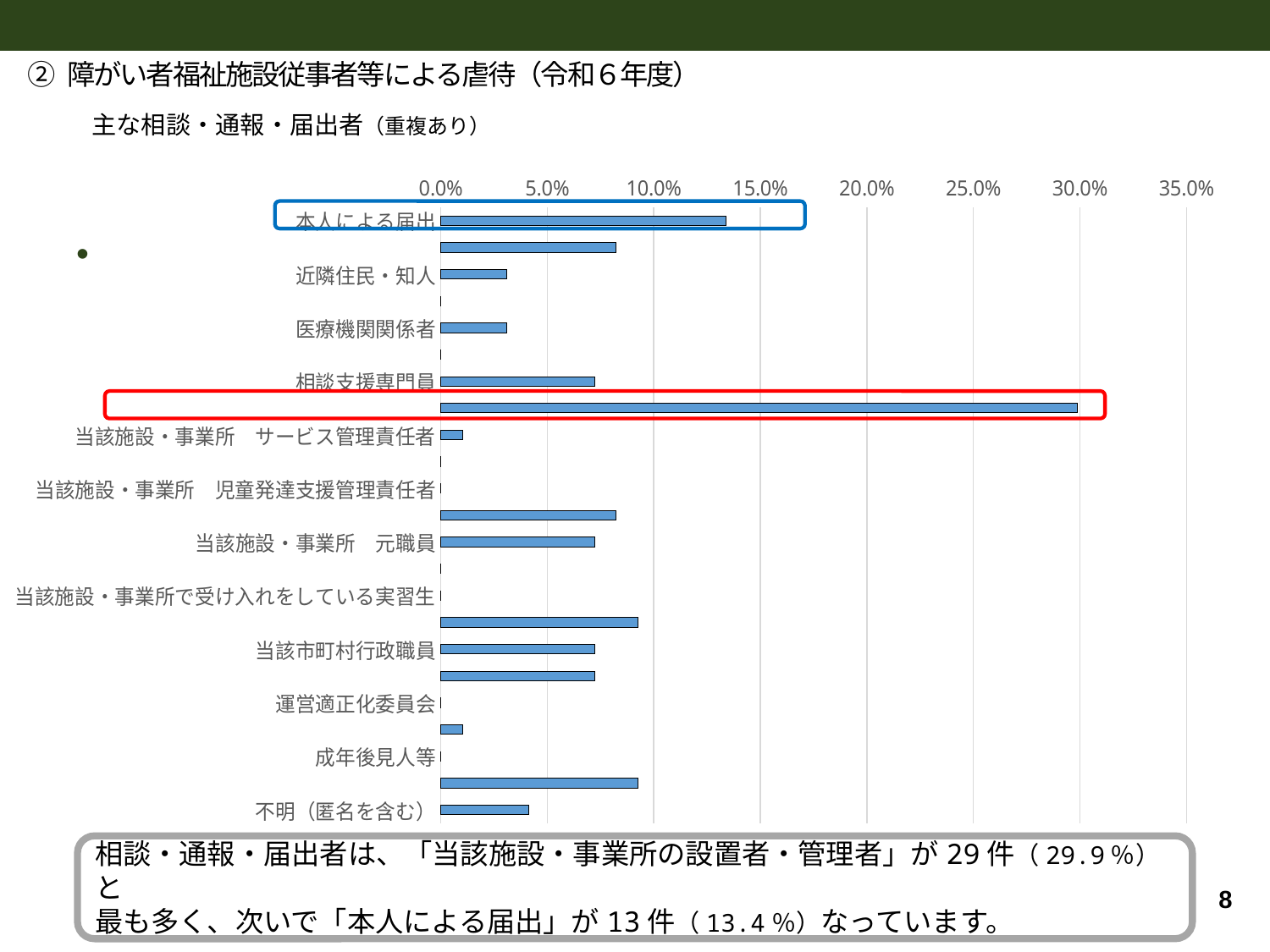
Is the value for 不明（匿名を含む） greater or less than 5.0%? less What is the highest value shown on the horizontal axis? 35.0% What is the difference between the values for 当該施設・事業所の設置者・管理者 and 本人による届出? 16.5 percentage points Which is larger, the value for 当該市町村行政職員 or the value for 不明（匿名を含む）? 当該市町村行政職員 What is the value for 本人による届出? 13.4% Which category has the highest value? 当該施設・事業所の設置者・管理者 Which is larger, the value for 相談支援専門員 or the value for 医療機関関係者? 相談支援専門員 Is the value for 本人による届出 greater or less than 10.0%? greater What kind of chart is shown on the slide? bar chart What is the value for 当該施設・事業所の設置者・管理者? 29.9% Is the value for 近隣住民・知人 greater or less than 5.0%? less